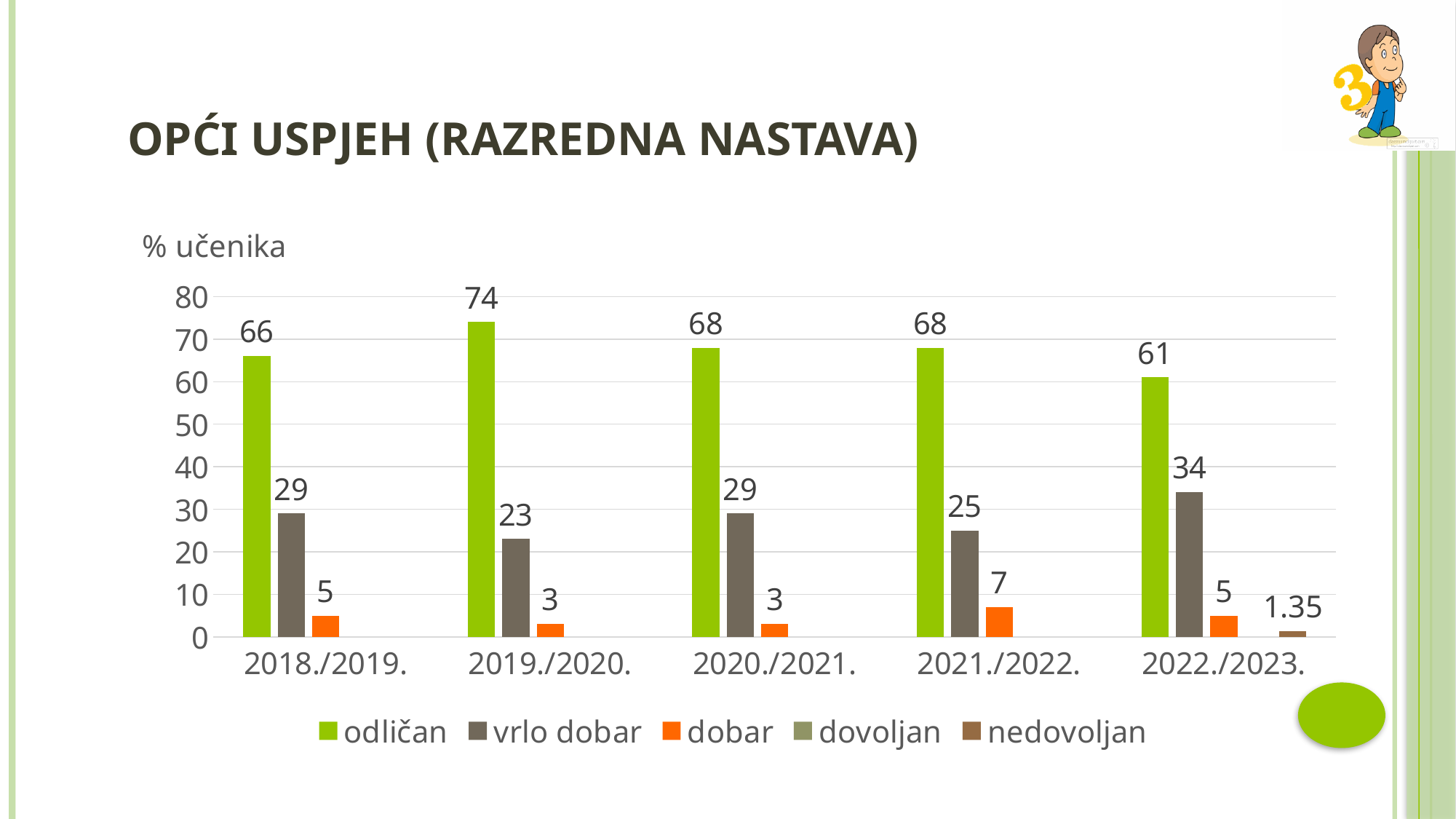
How many school-year categories are shown on the x axis? 5 What is the title of the slide containing the chart? OPĆI USPJEH (RAZREDNA NASTAVA) What is the value for odličan in 2019./2020.? 74 Which is larger: vrlo dobar in 2018./2019. or vrlo dobar in 2019./2020.? 2018./2019. How many series does the legend list? 5 What is the difference between the odličan values in 2019./2020. and 2022./2023.? 13 What is the value for dobar in 2021./2022.? 7 What type of chart is shown on the slide? bar chart In which school year is the odličan value highest? 2019./2020. What is the value for vrlo dobar in 2022./2023.? 34 In which school year is the odličan value lowest? 2022./2023. Does the odličan value rise or fall from 2021./2022. to 2022./2023.? fall